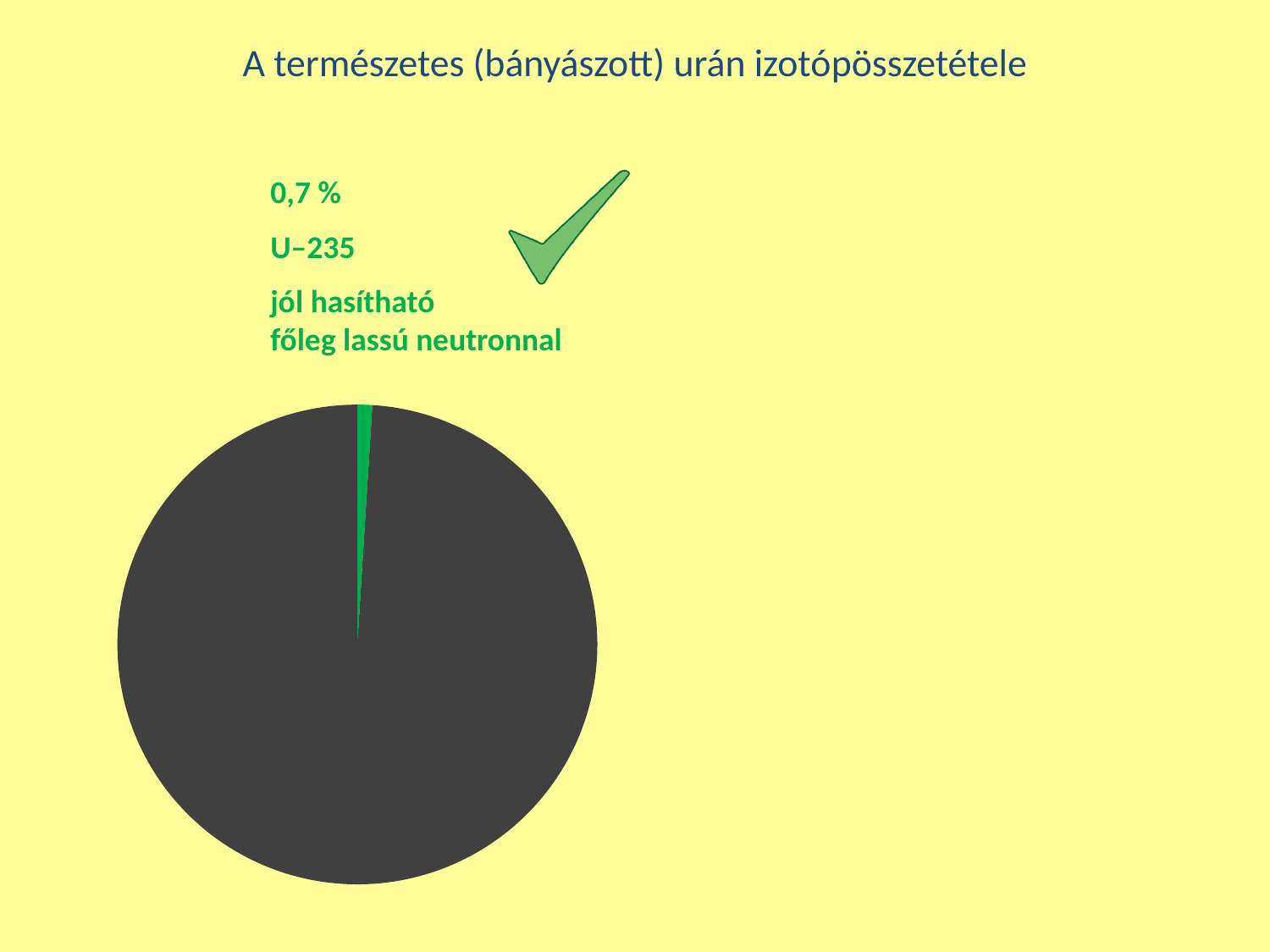
What kind of chart is shown on the slide? pie chart What colour is the U-235 slice in the pie chart? green Which slice of the pie is larger, the green slice or the dark grey slice? the dark grey slice What is the title of the slide containing the pie chart? A természetes (bányászott) urán izotópösszetétele Which slice of the pie is the smallest? the green slice (U-235) What is the value printed for U-235 on the slide? 0,7 % Which slice of the pie is the largest? the dark grey slice How many slices does the pie chart have? 2